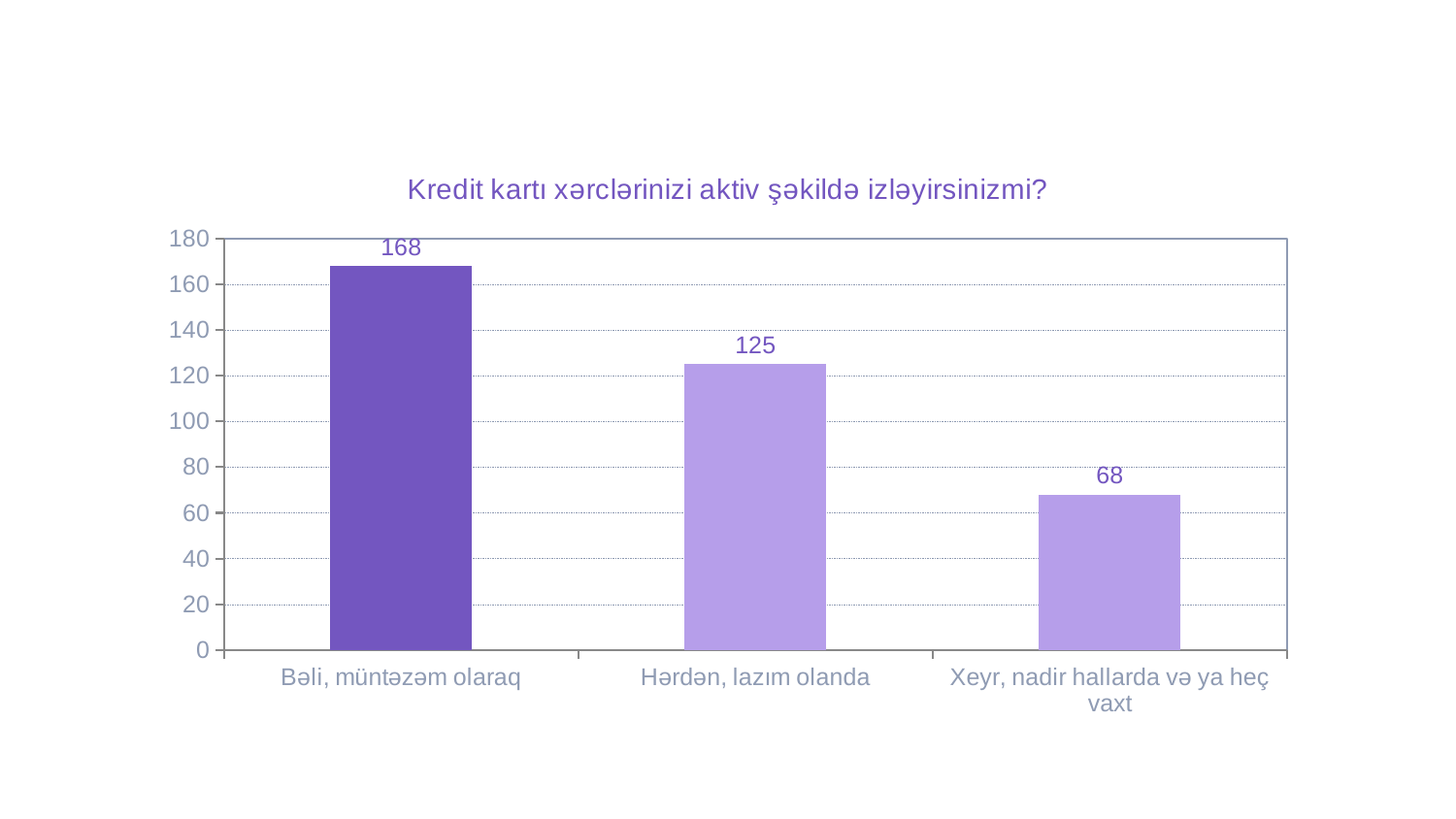
What is the difference between the values for "Bəli, müntəzəm olaraq" and "Hərdən, lazım olanda"? 43 Which category has the highest value? Bəli, müntəzəm olaraq What kind of chart is shown on the slide? bar chart How many categories are shown in the chart? 3 Which category has the lowest value? Xeyr, nadir hallarda və ya heç vaxt What is the difference between the values for "Hərdən, lazım olanda" and "Xeyr, nadir hallarda və ya heç vaxt"? 57 What is the title of the chart? Kredit kartı xərclərinizi aktiv şəkildə izləyirsinizmi? What is the value for "Bəli, müntəzəm olaraq"? 168 Is the value for "Hərdən, lazım olanda" greater or less than 140? less Which is larger, the value for "Hərdən, lazım olanda" or the value for "Xeyr, nadir hallarda və ya heç vaxt"? Hərdən, lazım olanda What is the value for "Hərdən, lazım olanda"? 125 What is the value for "Xeyr, nadir hallarda və ya heç vaxt"? 68